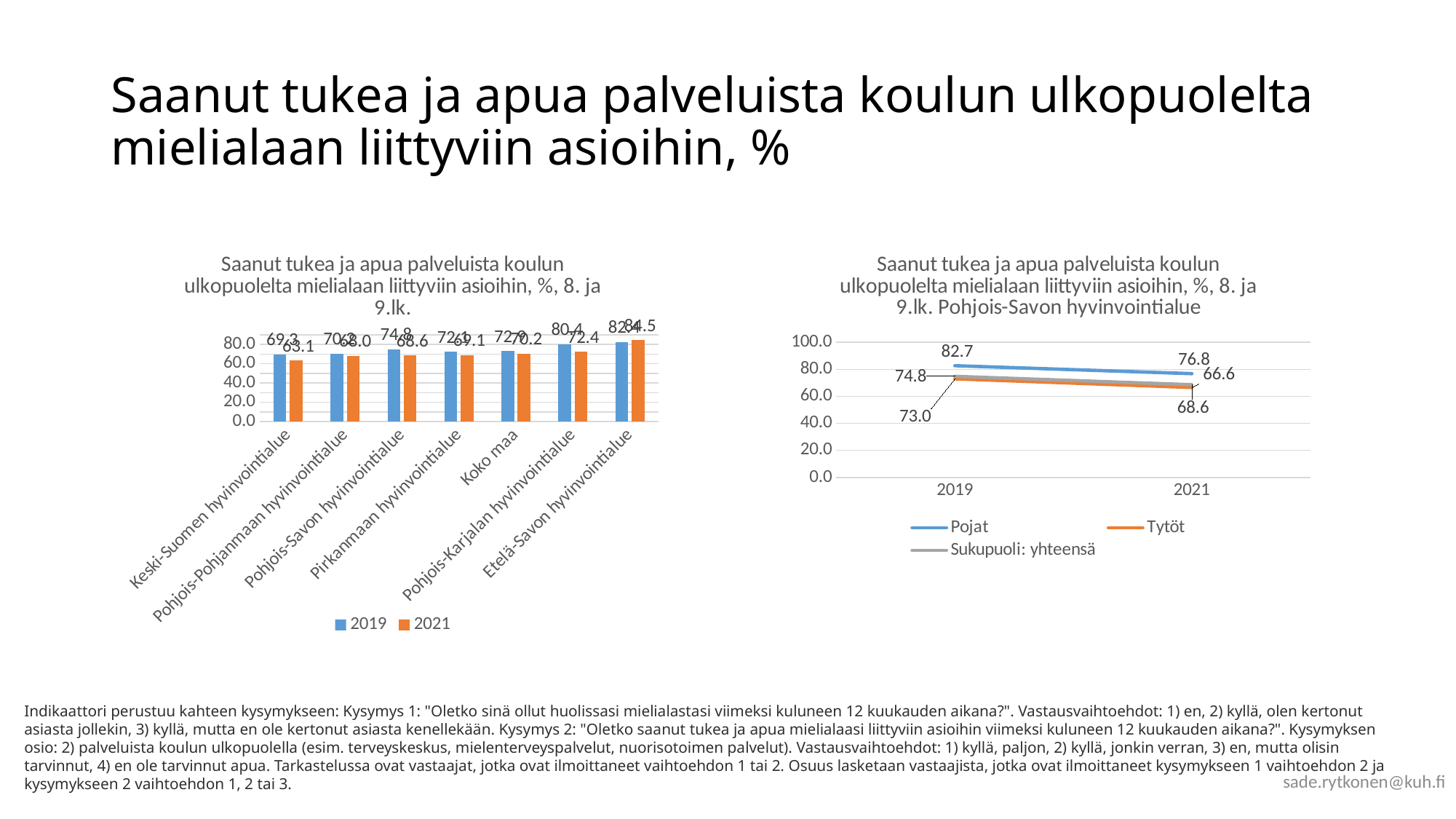
In the left chart, what is the 2019 value for Pohjois-Karjalan hyvinvointialue? 80.4 In the right chart, what is the value for Tytöt in 2021? 66.6 In the left chart, is the 2021 value for Pohjois-Karjalan hyvinvointialue greater or less than the 2019 value? less In the left chart, what is the 2021 value for Keski-Suomen hyvinvointialue? 63.1 In the right chart, what is the value for Pojat in 2019? 82.7 What kind of chart is the chart on the right? line chart In the left chart, what is the 2021 value for Etelä-Savon hyvinvointialue? 84.5 In the right chart, how many series does the legend list? 3 In the left chart, which category has the lowest 2021 value? Keski-Suomen hyvinvointialue In the left chart, how many categories are shown on the x axis? 7 In the right chart, does the Pojat line rise or fall from 2019 to 2021? fall In the left chart, what is the difference between the 2019 and 2021 values for Pohjois-Savon hyvinvointialue? 6.2